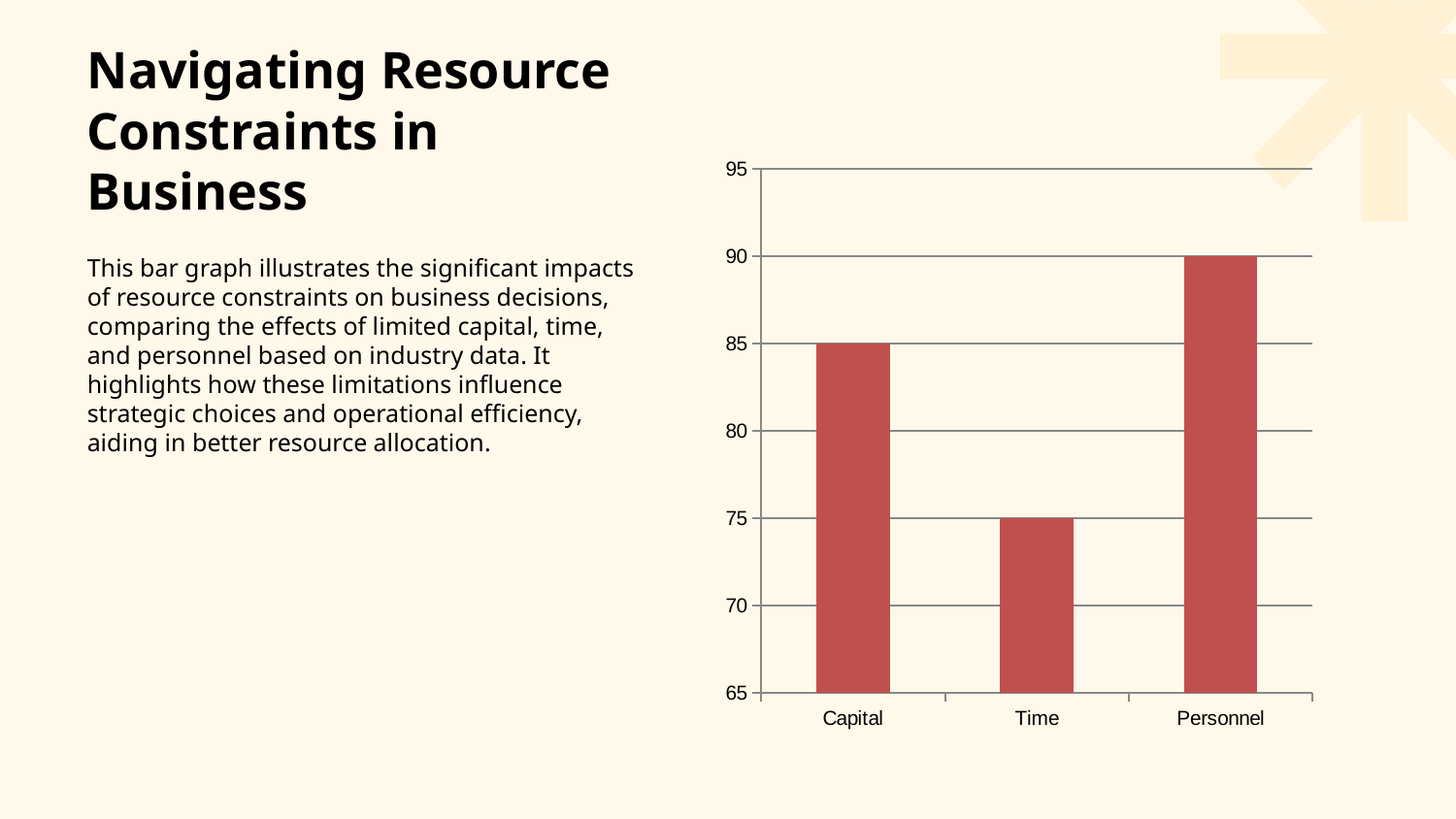
Is the value for Time greater or less than 80? less Which category has the lowest value? Time What is the difference between the values for Personnel and Time? 15 How many categories are shown on the x axis? 3 What is the lowest value shown on the vertical axis? 65 What is the difference between the values for Capital and Time? 10 What is the value for Personnel? 90 What is the value for Time? 75 What is the value for Capital? 85 What kind of chart is shown on the slide? bar chart Which category has the highest value? Personnel Which is larger, the value for Capital or the value for Personnel? Personnel